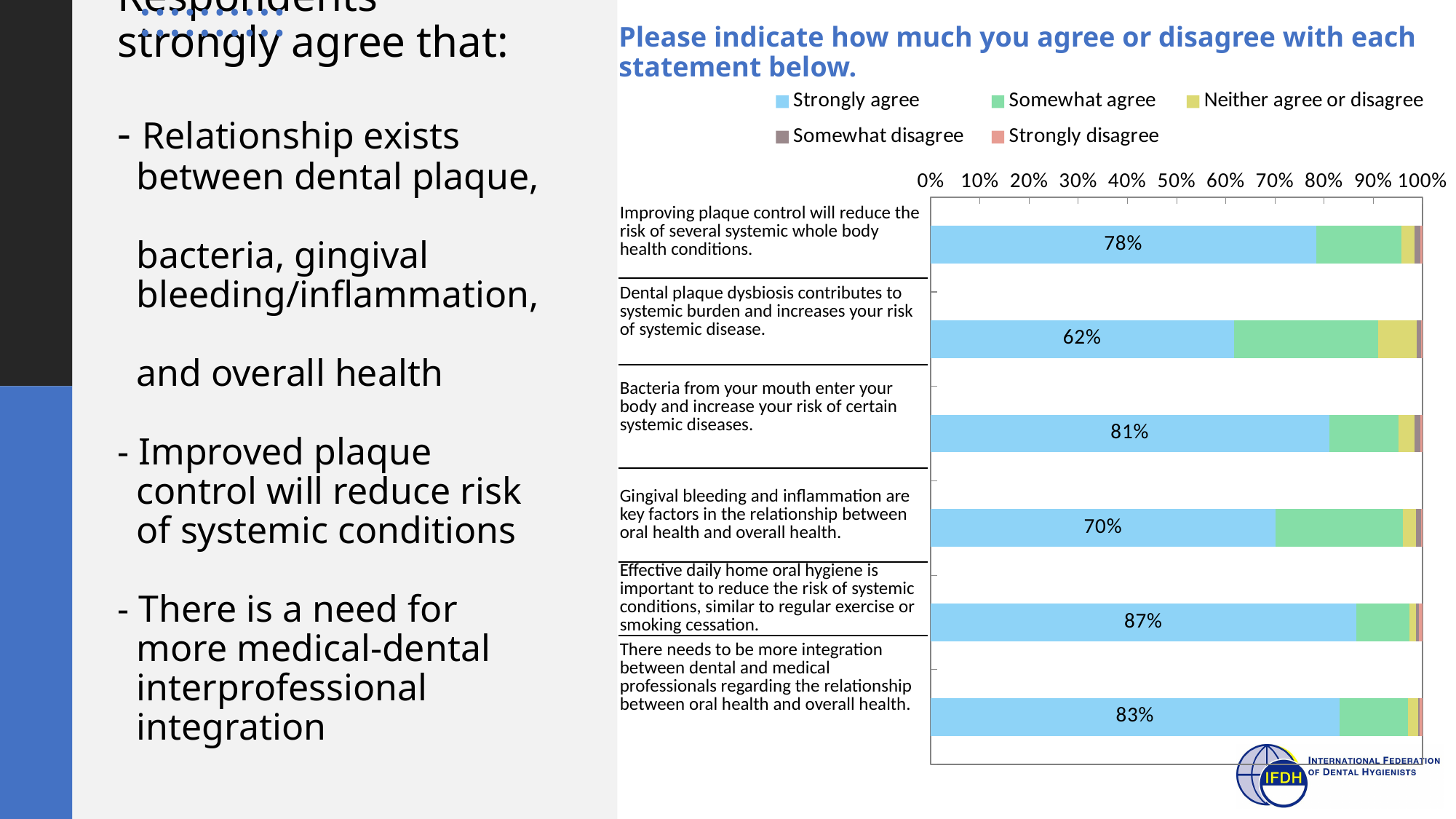
What type of chart is shown on the slide? Stacked bar chart Which statement has the highest 'Strongly agree' percentage? Effective daily home oral hygiene is important to reduce the risk of systemic conditions, similar to regular exercise or smoking cessation. Which has a higher 'Strongly agree' percentage: the statement that bacteria from your mouth enter your body and increase your risk of certain systemic diseases, or the statement that gingival bleeding and inflammation are key factors in the relationship between oral health and overall health? Bacteria from your mouth enter your body and increase your risk of certain systemic diseases. What is the 'Strongly agree' value for the statement 'Dental plaque dysbiosis contributes to systemic burden and increases your risk of systemic disease'? 62% What is the difference in 'Strongly agree' percentage between the statement about effective daily home oral hygiene (87%) and the statement about dental plaque dysbiosis (62%)? 25% How many response categories does the legend list? 5 What percentage of respondents strongly agree that improving plaque control will reduce the risk of several systemic whole body health conditions? 78% Which colour represents 'Strongly agree' in the chart? Light blue How many statements are shown in the chart? 6 Is the 'Strongly agree' value for the statement about more integration between dental and medical professionals greater or less than 80%? greater What share of respondents strongly agree that effective daily home oral hygiene is important to reduce the risk of systemic conditions? 87% Which statement has the lowest 'Strongly agree' percentage? Dental plaque dysbiosis contributes to systemic burden and increases your risk of systemic disease.